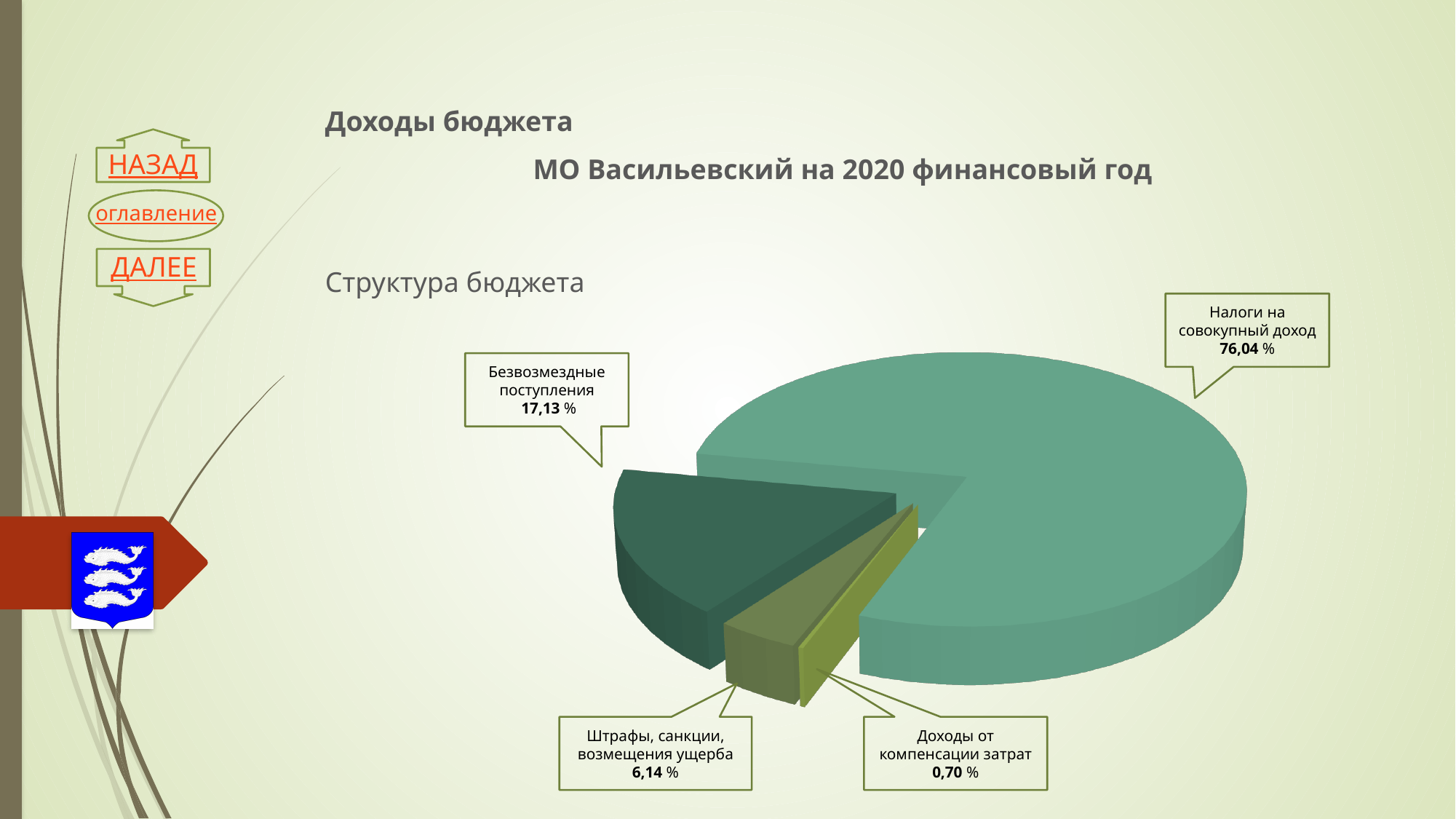
What share of the budget comes from Безвозмездные поступления? 17,13 % What is the title of the chart section on the slide? Структура бюджета What share of the budget comes from Штрафы, санкции, возмещения ущерба? 6,14 % For which financial year is the budget structure shown? 2020 How many categories are shown in the pie chart? 4 What kind of chart is shown on the slide? Pie chart Which category has the largest share of the budget? Налоги на совокупный доход What share of the budget comes from Налоги на совокупный доход? 76,04 % What share of the budget comes from Доходы от компенсации затрат? 0,70 % Which is larger: the share for Штрафы, санкции, возмещения ущерба or the share for Доходы от компенсации затрат? Штрафы, санкции, возмещения ущерба What is the difference in percentage points between Налоги на совокупный доход and Безвозмездные поступления? 58,91 Which category has the smallest share of the budget? Доходы от компенсации затрат